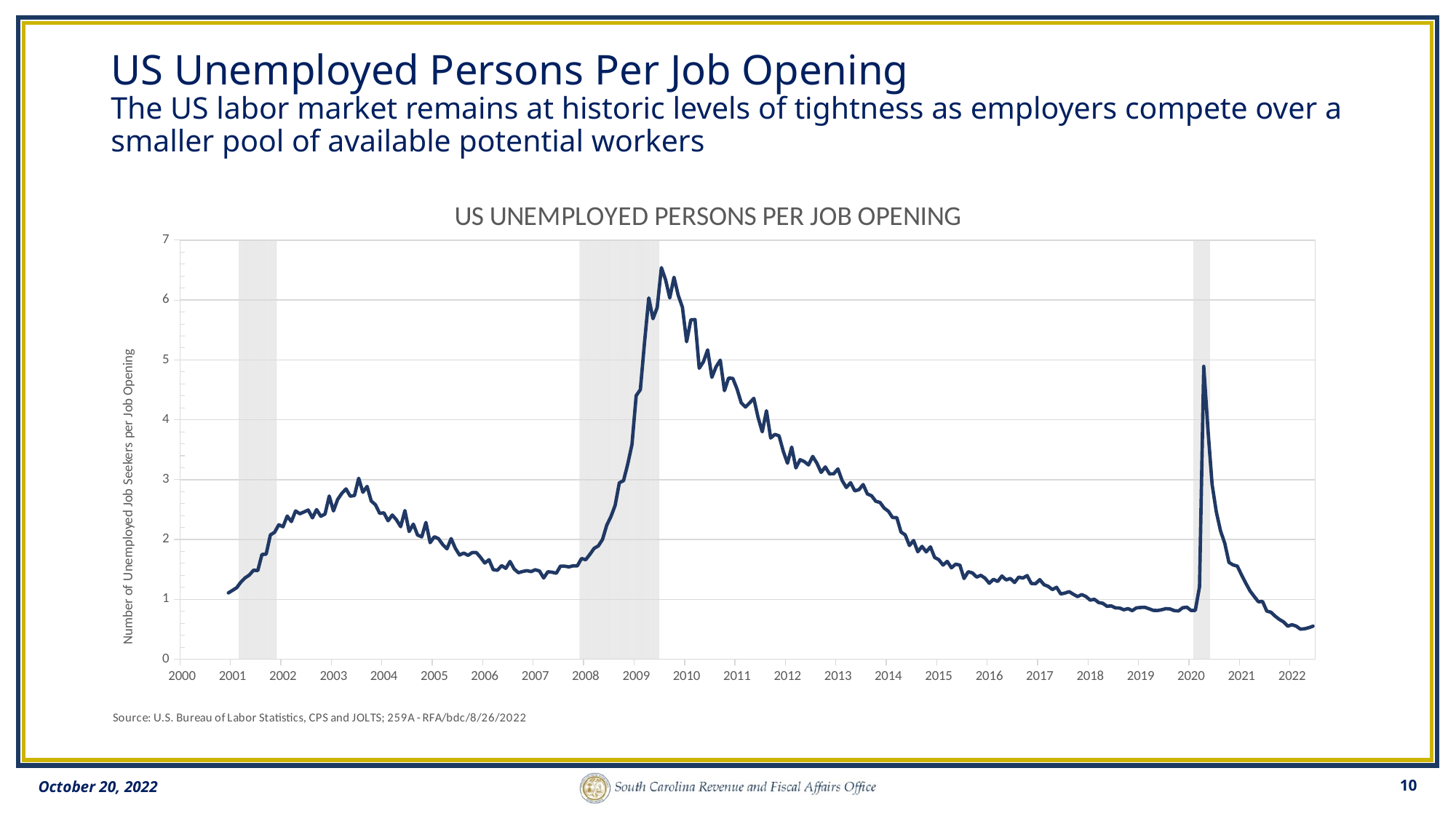
Is the value at the end of the series in 2022 greater or less than 1? less Which is higher, the peak in 2009 or the spike in 2020? the peak in 2009 In which year does the series reach its highest value? 2009 Is the spike value in 2020 greater or less than 4? greater Does the number of unemployed persons per job opening rise or fall between 2008 and 2009? rise What kind of chart is shown on the slide? line chart What is the label on the vertical axis of the chart? Number of Unemployed Job Seekers per Job Opening Does the number of unemployed persons per job opening rise or fall between 2010 and 2019? fall What is the title of the chart? US UNEMPLOYED PERSONS PER JOB OPENING Is the value in 2017 greater or less than 2? less